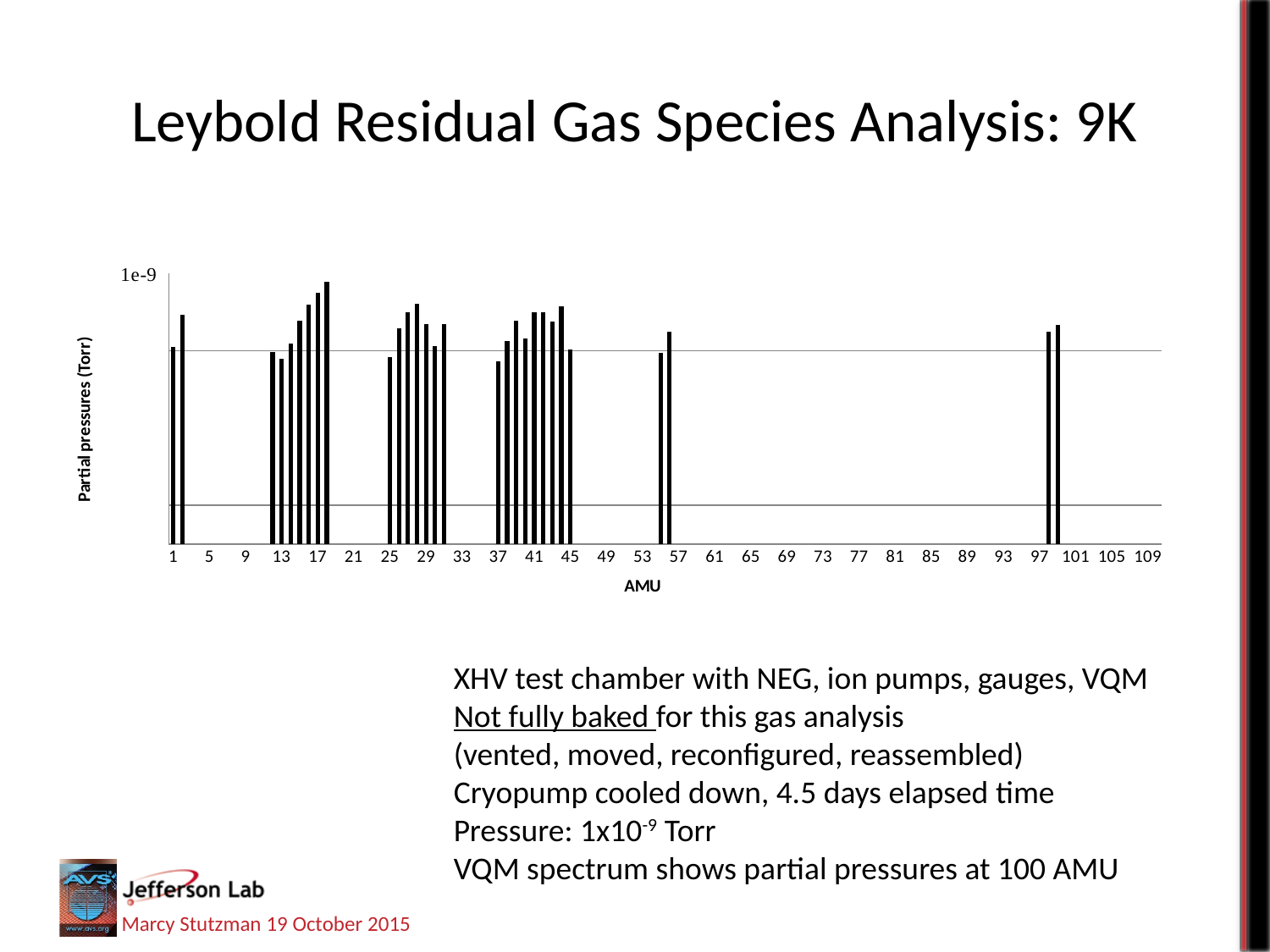
What kind of chart is shown on the slide? bar chart Which has the larger partial pressure, AMU 18 or AMU 28? AMU 18 What is the title of the x axis of the chart? AMU Which has the larger partial pressure, AMU 55 or AMU 56? AMU 56 Is the value for AMU 18 greater or less than 1e-9? less What is the highest AMU tick label shown on the x axis? 109 At which AMU is the tallest bar in the chart? 18 Which has the larger partial pressure, AMU 2 or AMU 98? AMU 2 What is the title of the y axis of the chart? Partial pressures (Torr)